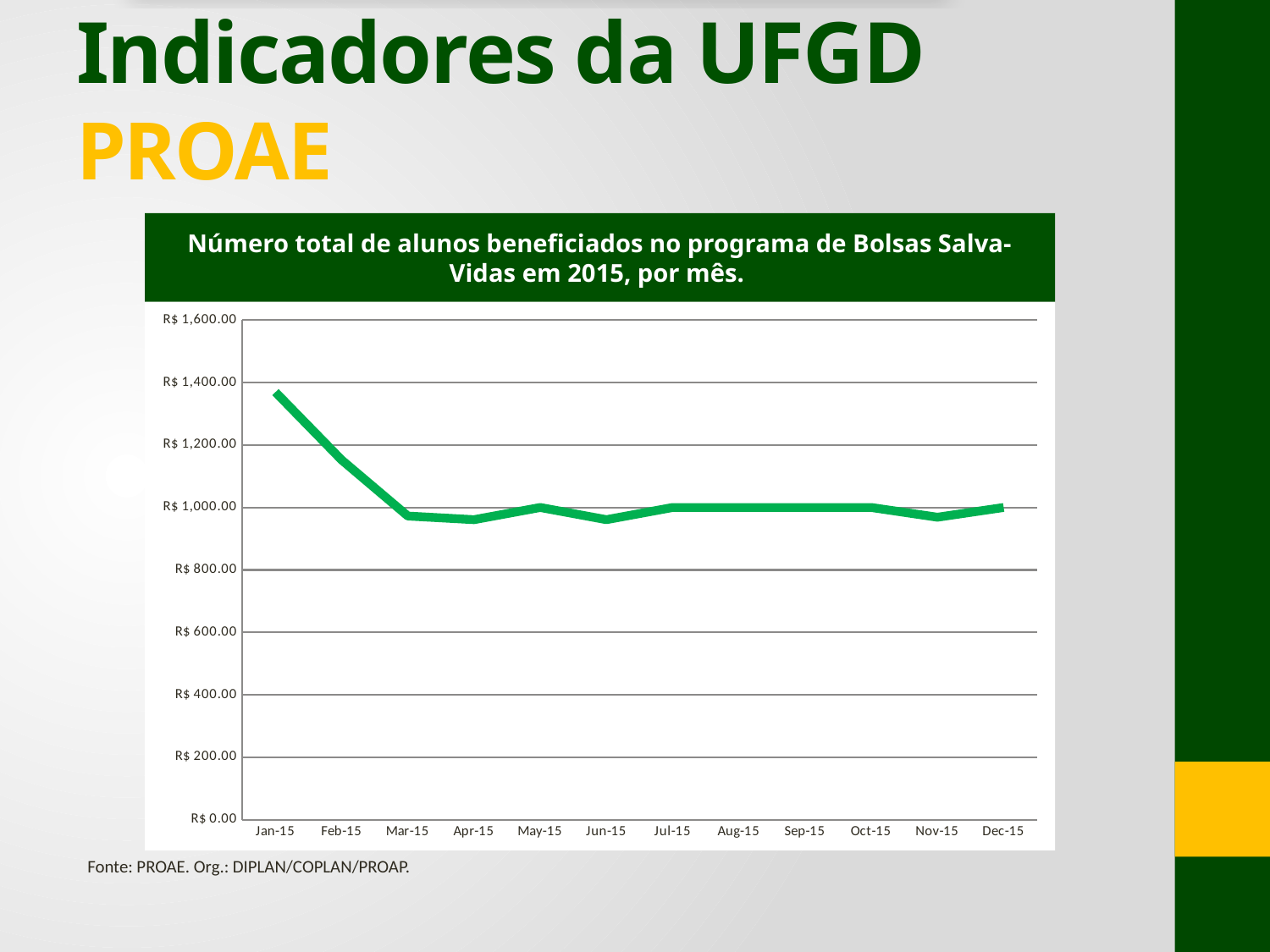
Is the value for Mar-15 greater or less than R$ 1,200.00? less What kind of chart is shown on the slide? line chart Do the values rise or fall from Jan-15 to Mar-15? fall Is the value for Feb-15 greater or less than R$ 1,000.00? greater How many months are plotted along the x axis? 12 Is the value for Sep-15 greater or less than R$ 800.00? greater Which is larger, the value for Jan-15 or the value for Feb-15? Jan-15 Which is larger, the value for Feb-15 or the value for Mar-15? Feb-15 Which month has the highest value? Jan-15 What is the title of the chart? Número total de alunos beneficiados no programa de Bolsas Salva-Vidas em 2015, por mês. What colour is the plotted line? green